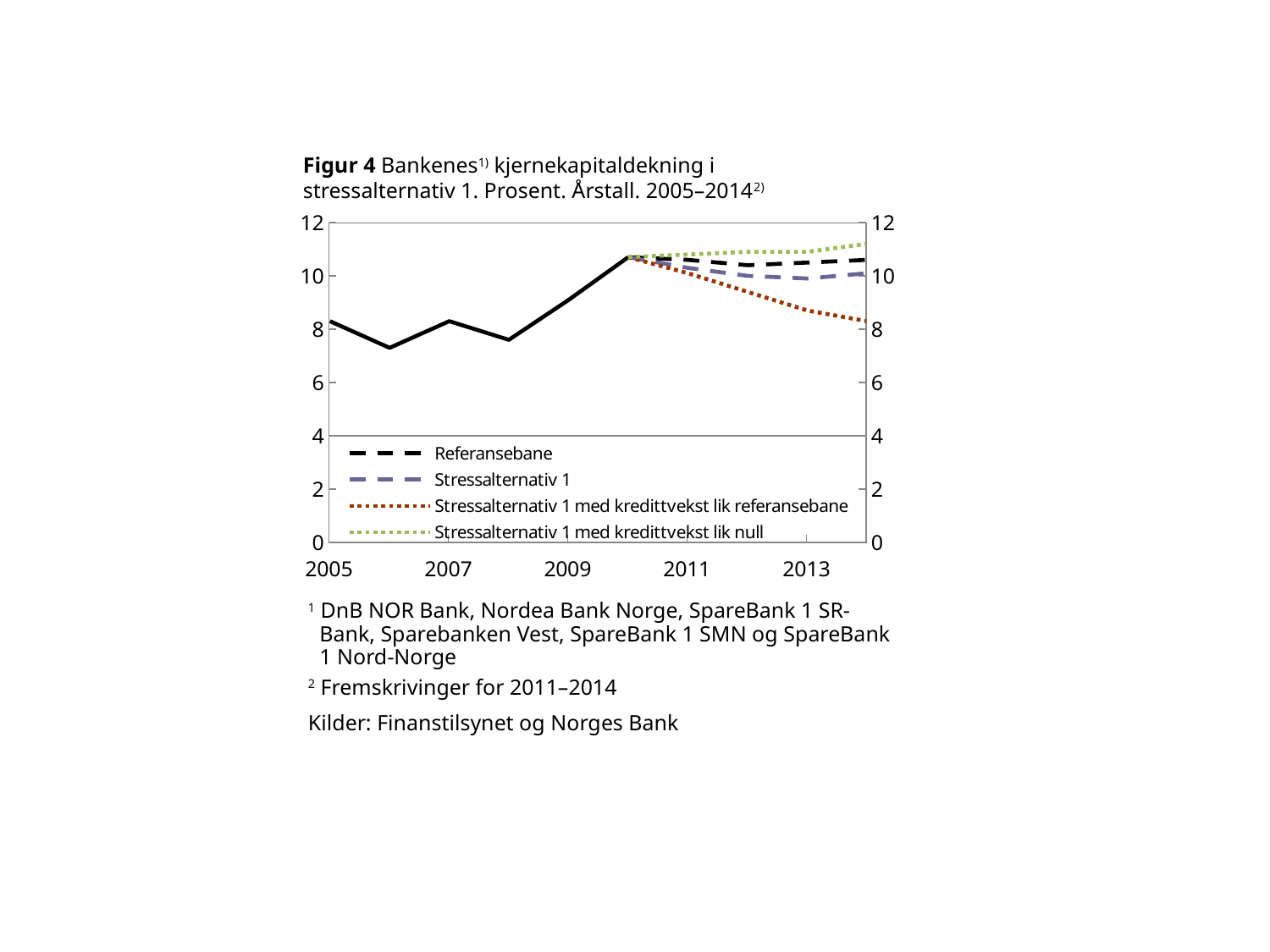
How many series does the legend list? 4 Is the value for 2010 greater or less than 10? greater Which series ends highest in 2014? Stressalternativ 1 med kredittvekst lik null In 2014, which series is higher: 'Stressalternativ 1 med kredittvekst lik null' or 'Stressalternativ 1 med kredittvekst lik referansebane'? Stressalternativ 1 med kredittvekst lik null Is the value for 2006 greater or less than 8? less What sources are cited for the chart? Finanstilsynet og Norges Bank Is the 2014 value of the 'Stressalternativ 1 med kredittvekst lik null' series greater or less than 10? greater Does the 'Stressalternativ 1 med kredittvekst lik null' series rise or fall from 2010 to 2014? rise Which series ends lowest in 2014? Stressalternativ 1 med kredittvekst lik referansebane Does the 'Stressalternativ 1 med kredittvekst lik referansebane' series rise or fall from 2010 to 2014? fall What kind of chart is shown on the slide? line chart